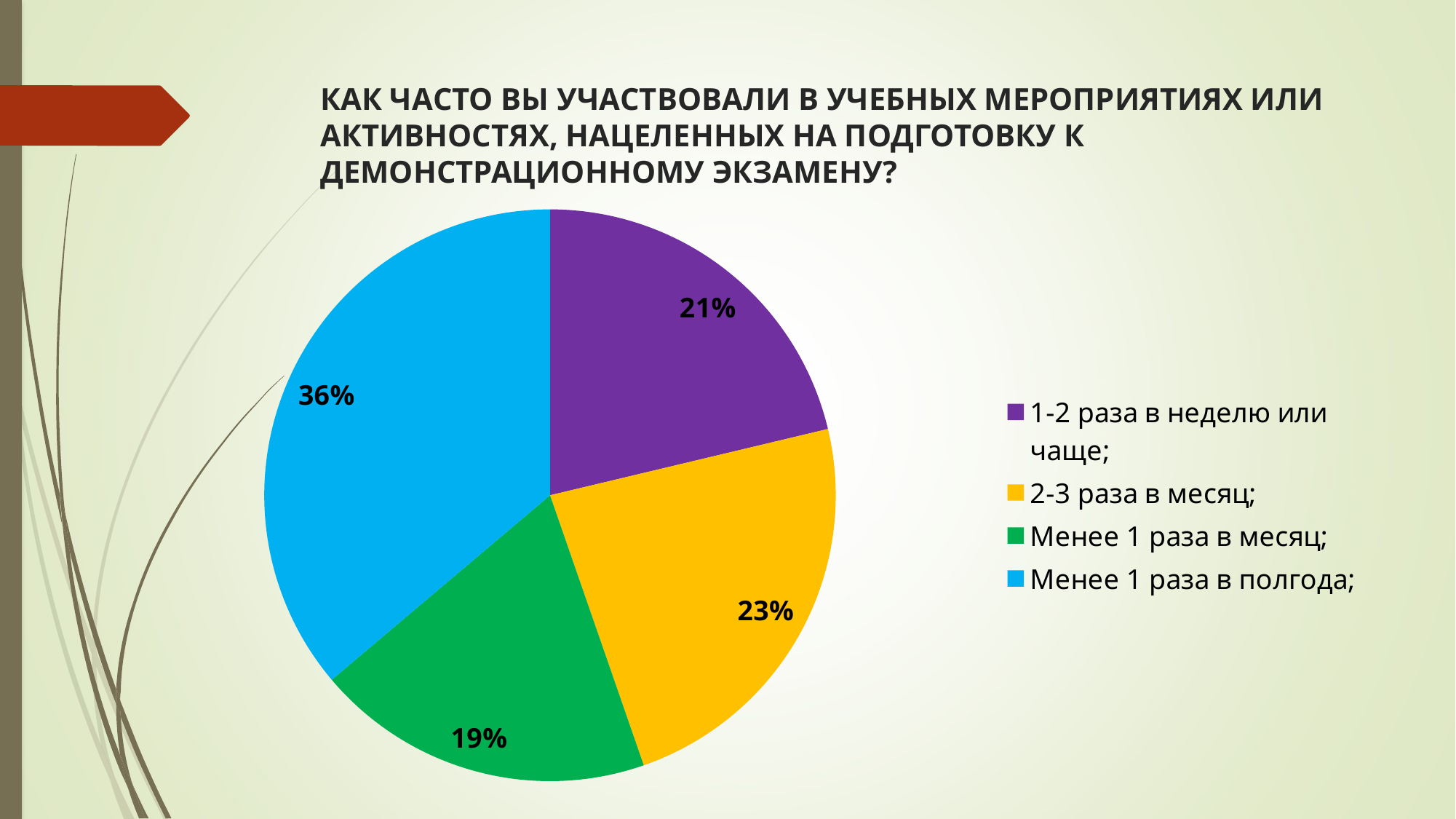
What is the value for "Менее 1 раза в месяц;"? 19% Which category has the smallest slice of the pie? Менее 1 раза в месяц; Which category has the largest slice of the pie? Менее 1 раза в полгода; What colour is the slice for "2-3 раза в месяц;"? yellow What is the value for "1-2 раза в неделю или чаще;"? 21% What is the difference between the values for "2-3 раза в месяц;" and "Менее 1 раза в месяц;"? 4% What is the value for "2-3 раза в месяц;"? 23% What share of the pie is labelled "Менее 1 раза в полгода;"? 36% What is the difference between the values for "Менее 1 раза в полгода;" and "1-2 раза в неделю или чаще;"? 15% Which is larger: the value for "2-3 раза в месяц;" or the value for "Менее 1 раза в месяц;"? 2-3 раза в месяц; What kind of chart is shown on the slide? pie chart How many categories does the pie chart have? 4